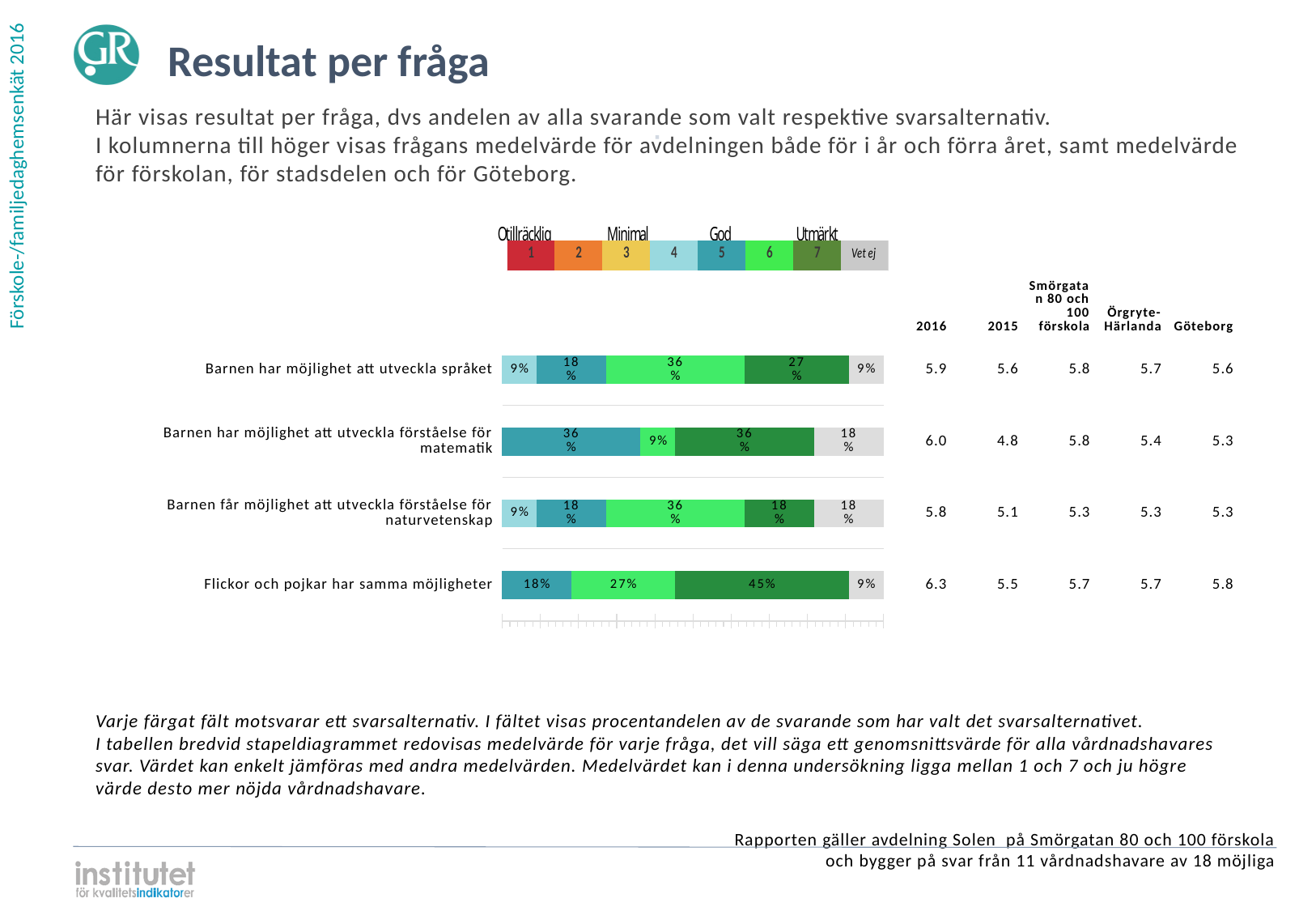
Which question has the largest share of 'Utmärkt' (7) responses? Flickor och pojkar har samma möjligheter What kind of chart is shown on the slide? stacked bar chart What percentage chose 'Vet ej' for 'Barnen har möjlighet att utveckla förståelse för matematik'? 18% For 'Barnen har möjlighet att utveckla språket', which is larger: the share for answer 6 or the share for answer 7? answer 6 How many questions (categories) are plotted in the bar chart? 4 How many answer alternatives does the legend above the chart list? 8 What percentage chose answer 5 (teal) for 'Barnen får möjlighet att utveckla förståelse för naturvetenskap'? 18% What is the 2015 mean value shown for 'Barnen har möjlighet att utveckla förståelse för matematik'? 4.8 What percentage chose answer 6 (light green) for 'Barnen har möjlighet att utveckla språket'? 36% What is the difference in percentage points between the 'Utmärkt' (7) share for 'Flickor och pojkar har samma möjligheter' and for 'Barnen har möjlighet att utveckla språket'? 18 What is the 2016 mean value shown for 'Flickor och pojkar har samma möjligheter'? 6.3 What percentage of respondents chose 'Utmärkt' (7) for 'Flickor och pojkar har samma möjligheter'? 45%